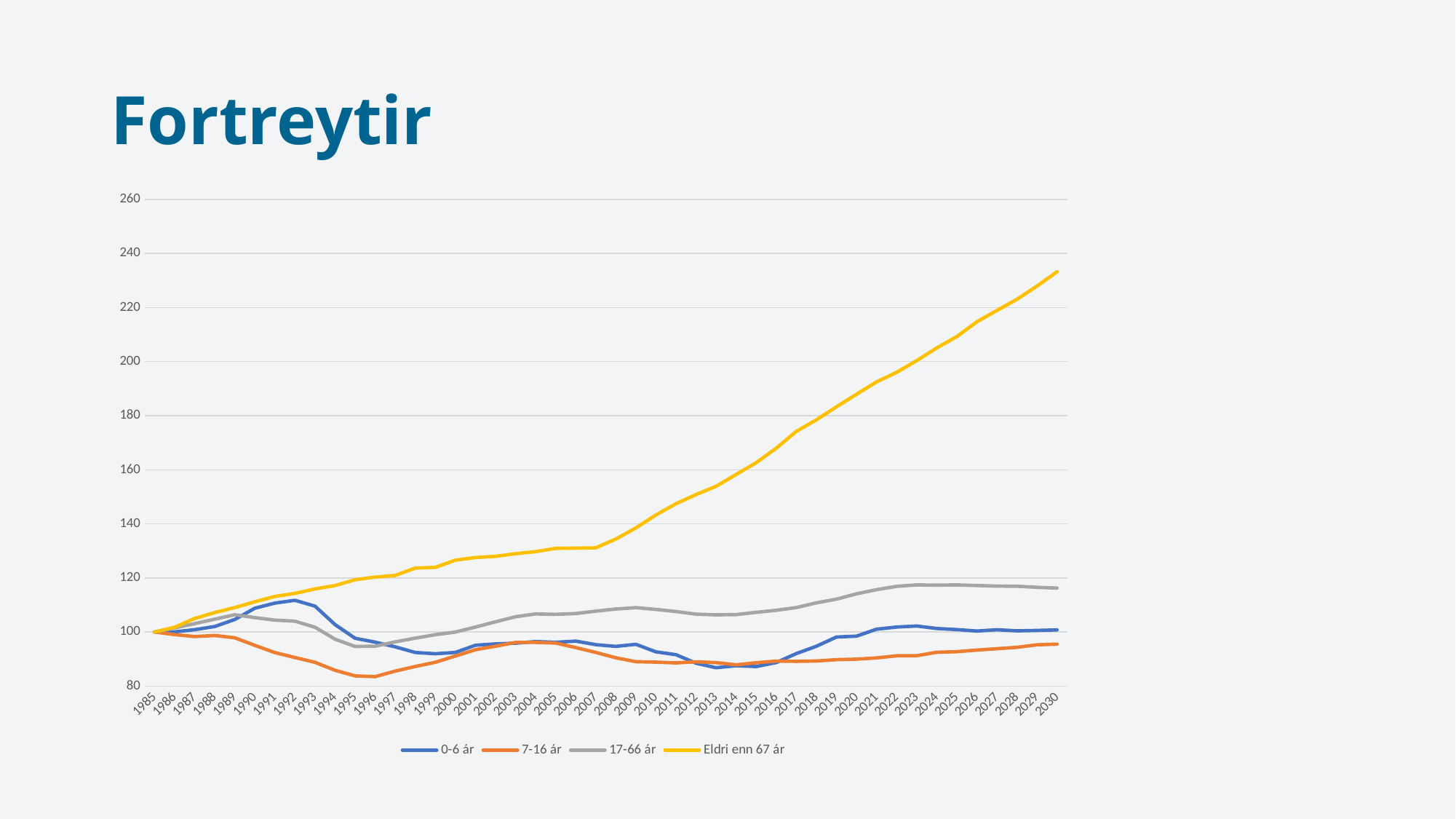
In 2030, which is larger: 17-66 ár or 0-6 ár? 17-66 ár Which series has the highest value in 2030? Eldri enn 67 ár What is the title of the slide? Fortreytir Is the value for 7-16 ár in 1996 greater or less than 90? less Is the value for Eldri enn 67 ár in 2030 greater or less than 220? greater Which series has the lowest value in 2030? 7-16 ár How many series does the legend list? 4 Does the Eldri enn 67 ár series rise or fall from 1985 to 2030? rise Is the value for 17-66 ár in 2030 greater or less than 120? less What kind of chart is shown on the slide? line chart How many years are shown along the x axis? 46 What value do all four series start at in 1985? 100